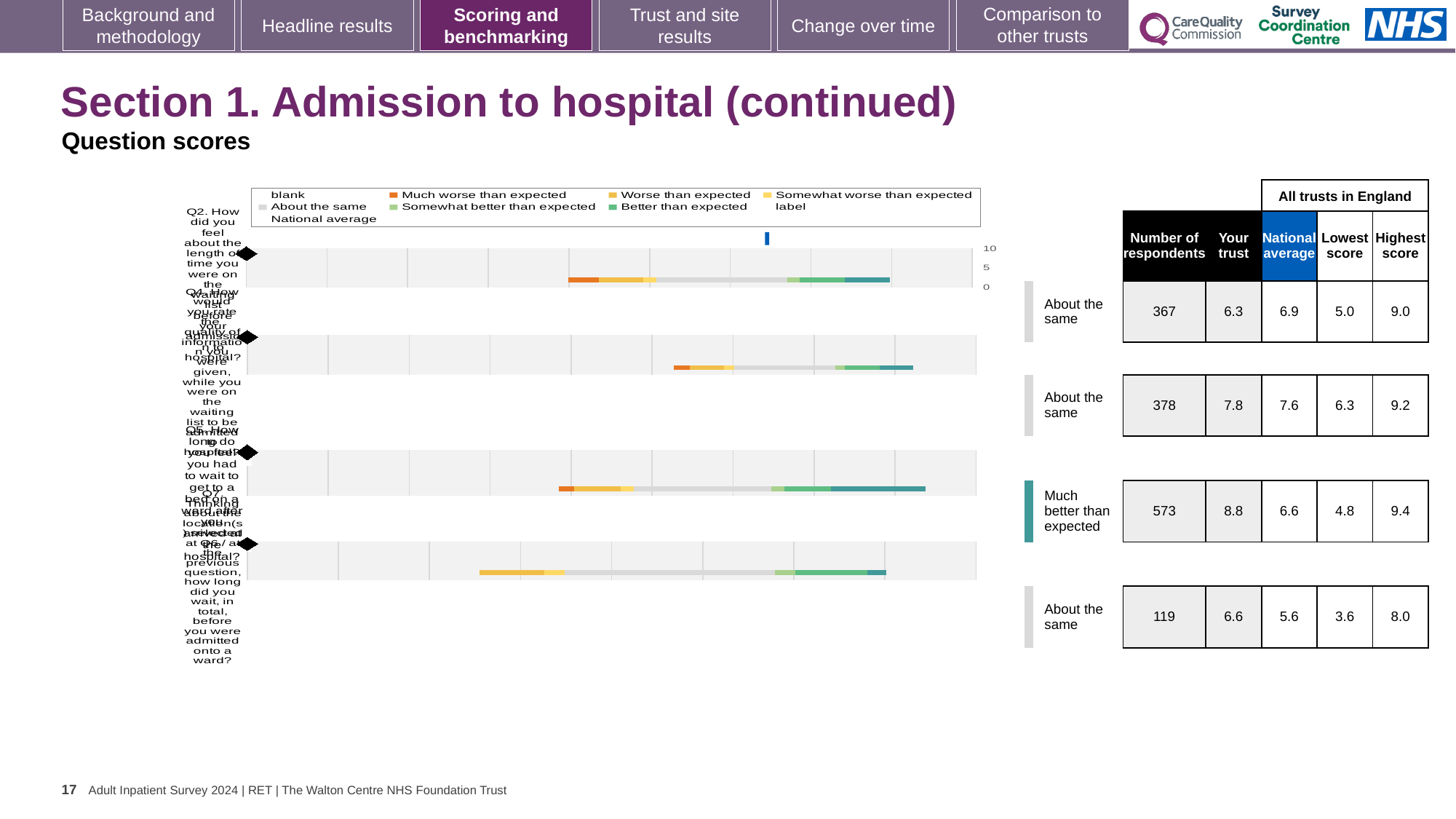
In the table, what is the number of respondents for the first row? 367 How many question rows are plotted in the chart? 4 Which row of the table has the lowest number of respondents? the fourth row (119) In the table, what is the lowest score for the first row? 5.0 In the table, what is the 'Your trust' score for the third row? 8.8 In the table, what is the highest score for the fourth row? 8.0 In the second row of the table, which is larger: the 'Your trust' score or the national average? Your trust (7.8) In the third row of the table, what is the difference between the 'Your trust' score and the national average? 2.2 Which row is rated 'Much better than expected'? the third row What kind of chart is shown on the left of the slide? bar chart Which row of the table has the highest 'Your trust' score? the third row (8.8) What is the maximum value shown on the chart's score axis? 10